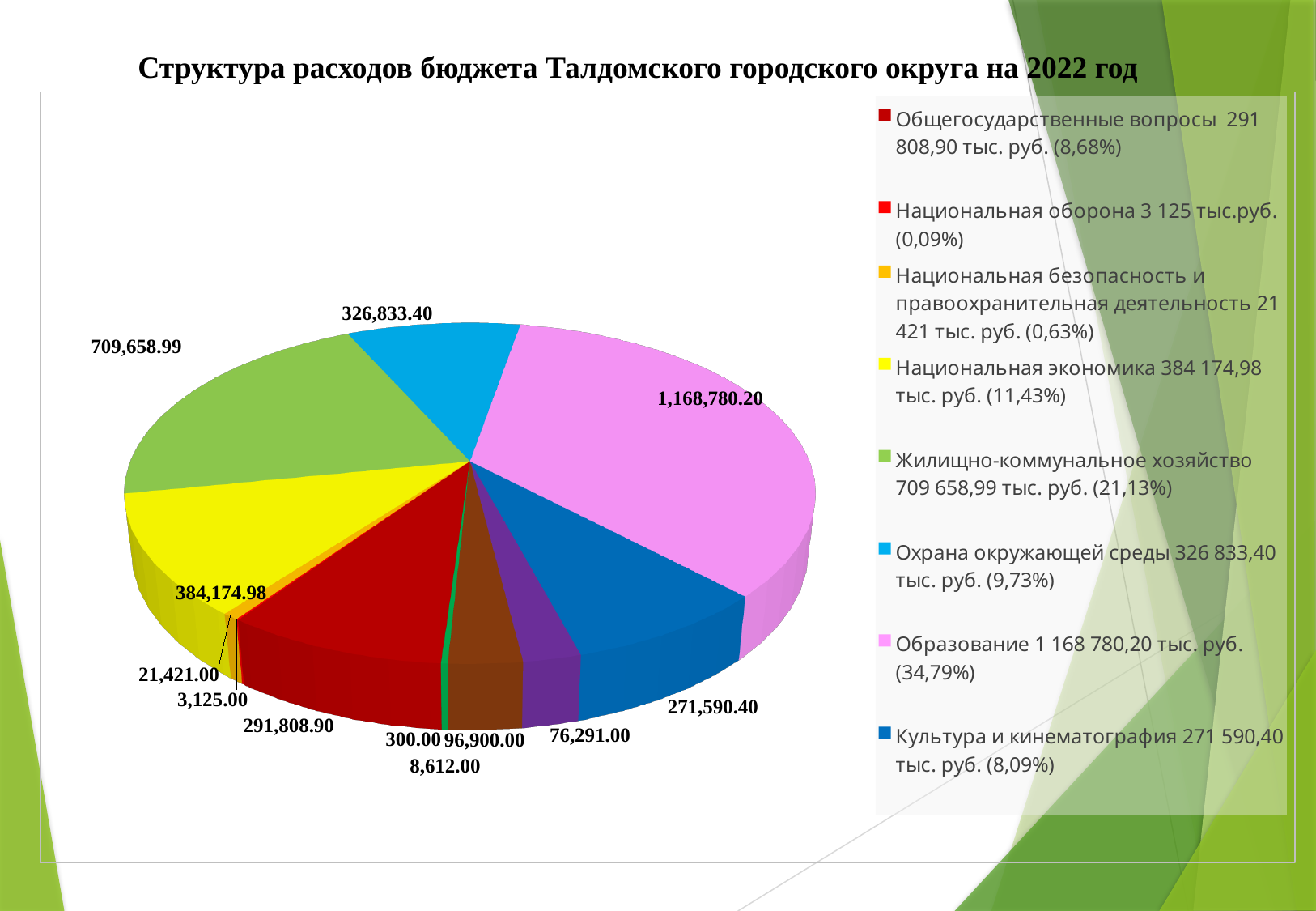
What is the title of the chart? Структура расходов бюджета Талдомского городского округа на 2022 год What is the data label value for the Жилищно-коммунальное хозяйство slice? 709,658.99 Which is larger: the value for Национальная экономика or the value for Охрана окружающей среды? Национальная экономика What kind of chart is shown on the slide? Pie chart What is the data label value for the Охрана окружающей среды slice? 326,833.40 How many data labels are shown on the pie chart? 12 What share of the pie does Образование represent, according to the legend? 34,79% What is the data label value for the Культура и кинематография slice? 271,590.40 What is the difference between the Образование value and the Жилищно-коммунальное хозяйство value? 459,121.21 What is the data label value for the Образование slice? 1,168,780.20 What share of the pie does Жилищно-коммунальное хозяйство represent, according to the legend? 21,13% Which category has the largest slice of the pie? Образование